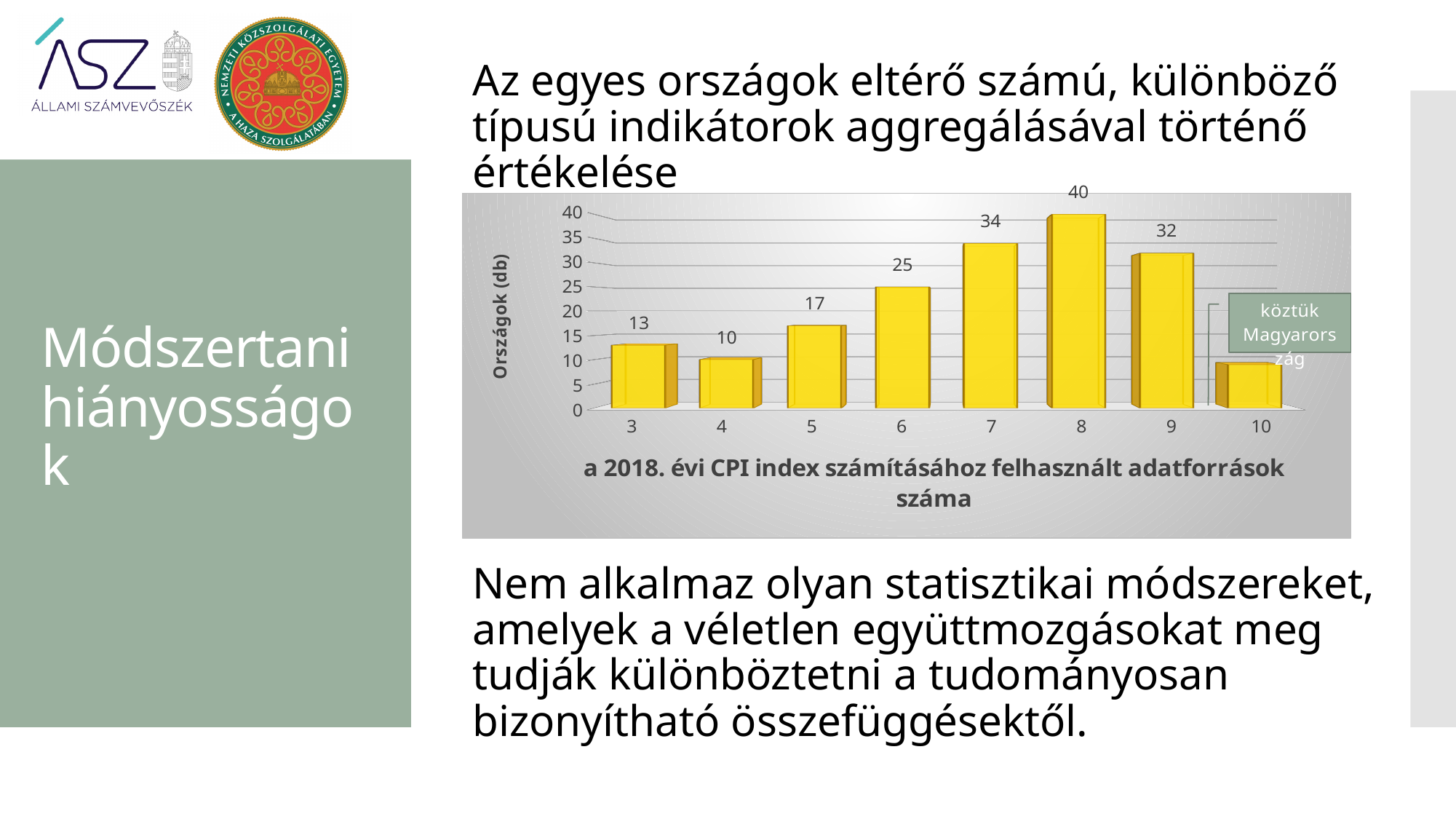
Which is larger, the value for category 5 or the value for category 3? 5 Do the values rise or fall from category 3 to category 8? rise What is the difference between the values for categories 8 and 7? 6 How many countries used 8 data sources for the 2018 CPI index calculation? 40 Which number of data sources has the highest number of countries? 8 What is the difference between the values for categories 9 and 3? 19 What kind of chart is shown on the slide? bar chart What is the label of the vertical axis of the chart? Országok (db) What is the value for category 4 on the chart? 10 What is the value for category 6 on the chart? 25 How many categories are shown on the x axis of the chart? 8 Is the value for category 10 greater or less than 15? less